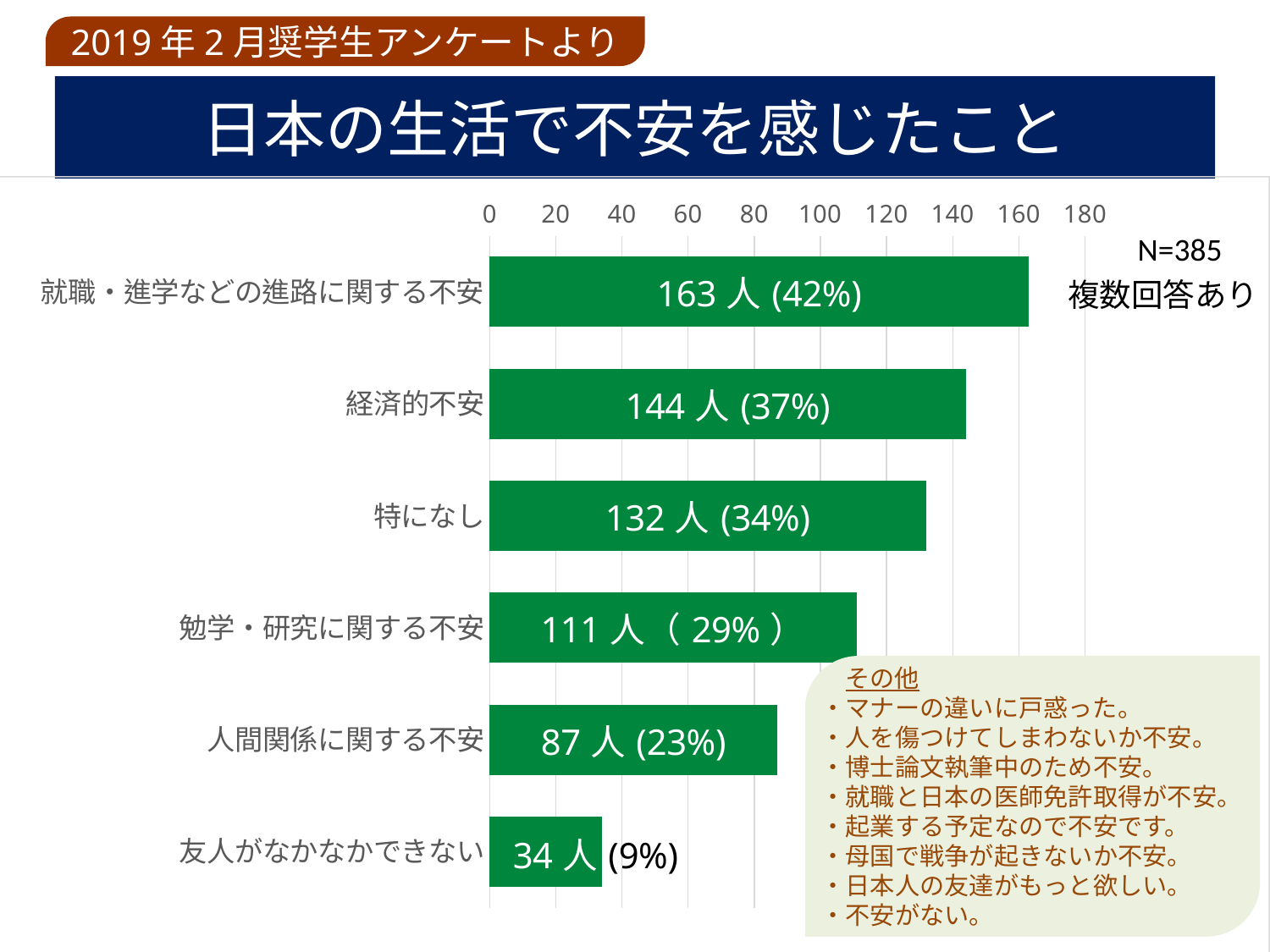
Is the value for 勉学・研究に関する不安 greater or less than 100? greater Which category has the highest value? 就職・進学などの進路に関する不安 What kind of chart is shown on the slide? bar chart What is the value for 経済的不安? 144人 (37%) What is the title of the chart? 日本の生活で不安を感じたこと What is the sample size (N) shown on the slide? N=385 What is the value for 特になし? 132人 (34%) Which category has the lowest value? 友人がなかなかできない Which is larger, the value for 特になし or the value for 勉学・研究に関する不安? 特になし What is the difference in number of people between 就職・進学などの進路に関する不安 and 経済的不安? 19人 What is the value for 人間関係に関する不安? 87人 (23%) How many categories are plotted in the chart? 6